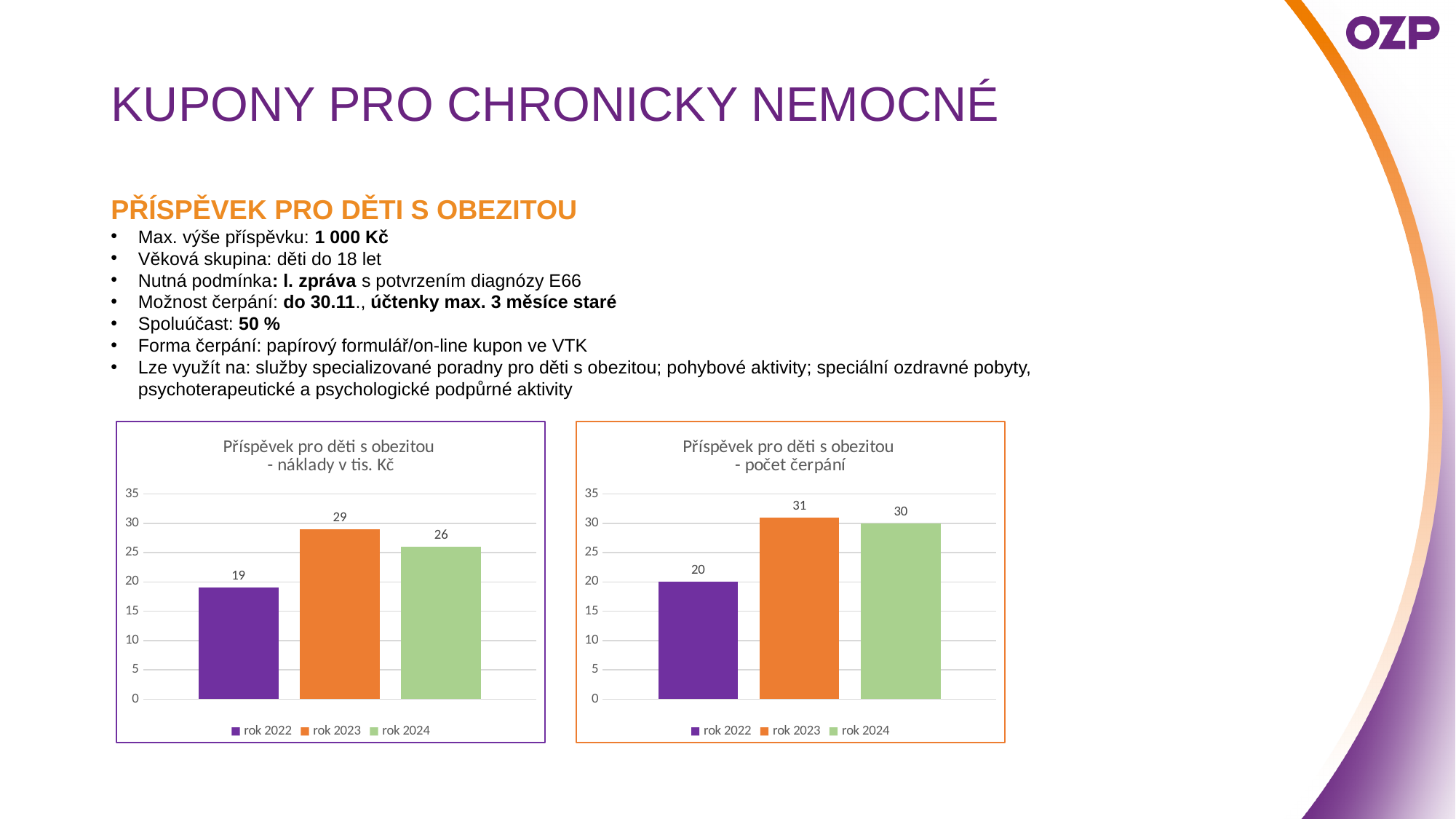
In the left chart 'Příspěvek pro děti s obezitou - náklady v tis. Kč', how many series does the legend list? 3 In the left chart 'Příspěvek pro děti s obezitou - náklady v tis. Kč', what is the value for rok 2024? 26 In the right chart 'Příspěvek pro děti s obezitou - počet čerpání', what is the value for rok 2022? 20 In the right chart 'Příspěvek pro děti s obezitou - počet čerpání', what colour is the bar for rok 2023? orange What kind of chart is the left chart 'Příspěvek pro děti s obezitou - náklady v tis. Kč'? bar chart In the left chart 'Příspěvek pro děti s obezitou - náklady v tis. Kč', what is the value for rok 2022? 19 In the right chart 'Příspěvek pro děti s obezitou - počet čerpání', what is the difference between rok 2023 and rok 2024? 1 In the left chart 'Příspěvek pro děti s obezitou - náklady v tis. Kč', which year has the highest value? rok 2023 In the left chart 'Příspěvek pro děti s obezitou - náklady v tis. Kč', what is the difference between rok 2023 and rok 2022? 10 In the right chart 'Příspěvek pro děti s obezitou - počet čerpání', what is the value for rok 2023? 31 In the right chart 'Příspěvek pro děti s obezitou - počet čerpání', which year has the lowest value? rok 2022 In the right chart 'Příspěvek pro děti s obezitou - počet čerpání', is the value for rok 2024 greater or less than 25? greater